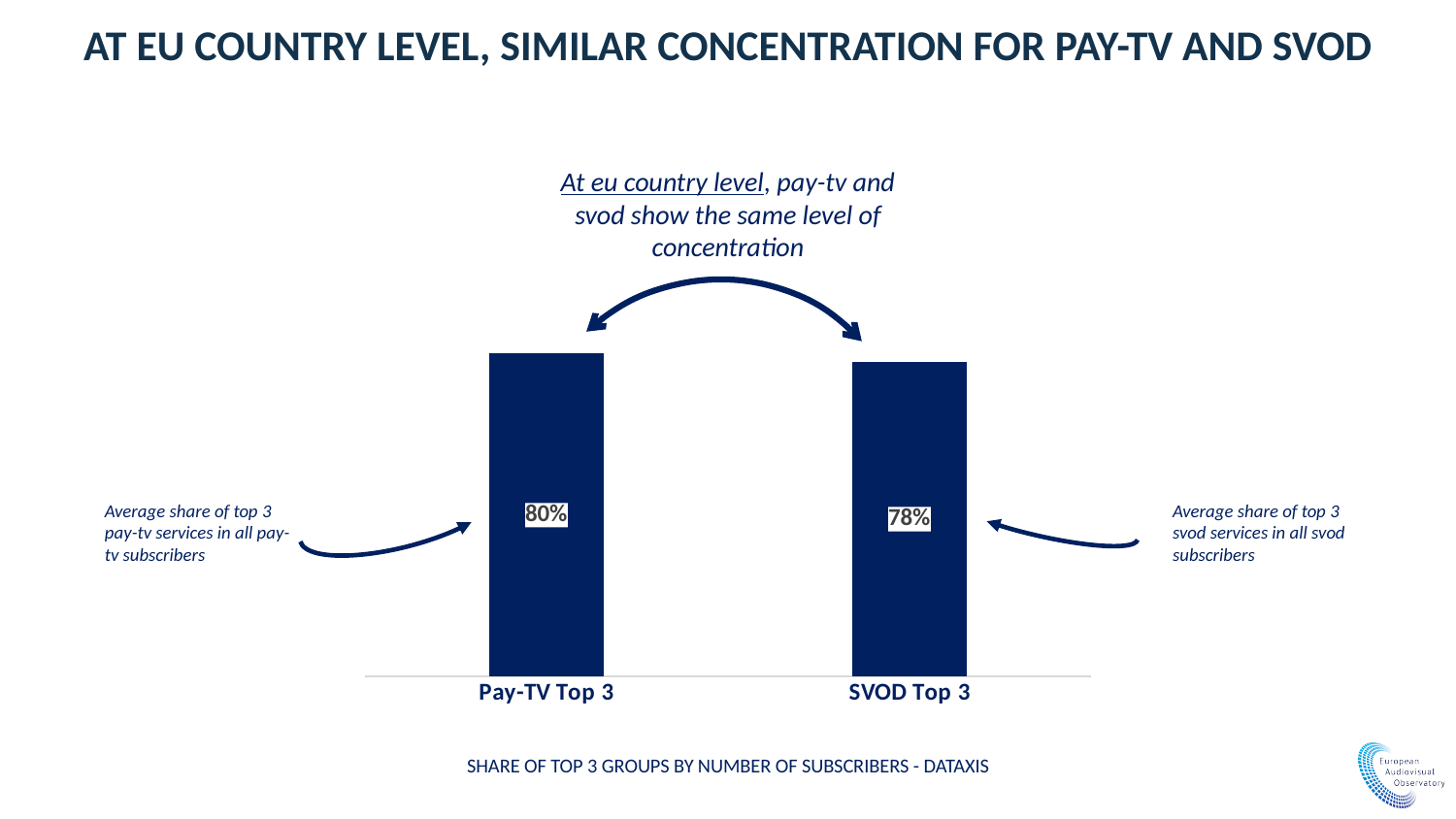
What kind of chart is shown on the slide? Bar chart What is the value for SVOD Top 3? 78% What is the difference between the Pay-TV Top 3 and SVOD Top 3 values? 2% Which category has the higher value, Pay-TV Top 3 or SVOD Top 3? Pay-TV Top 3 What colour are the bars in the chart? Dark blue What is the value for Pay-TV Top 3? 80% How many categories are shown in the chart? 2 Which category has the lowest value? SVOD Top 3 What is the source caption shown below the chart? SHARE OF TOP 3 GROUPS BY NUMBER OF SUBSCRIBERS - DATAXIS